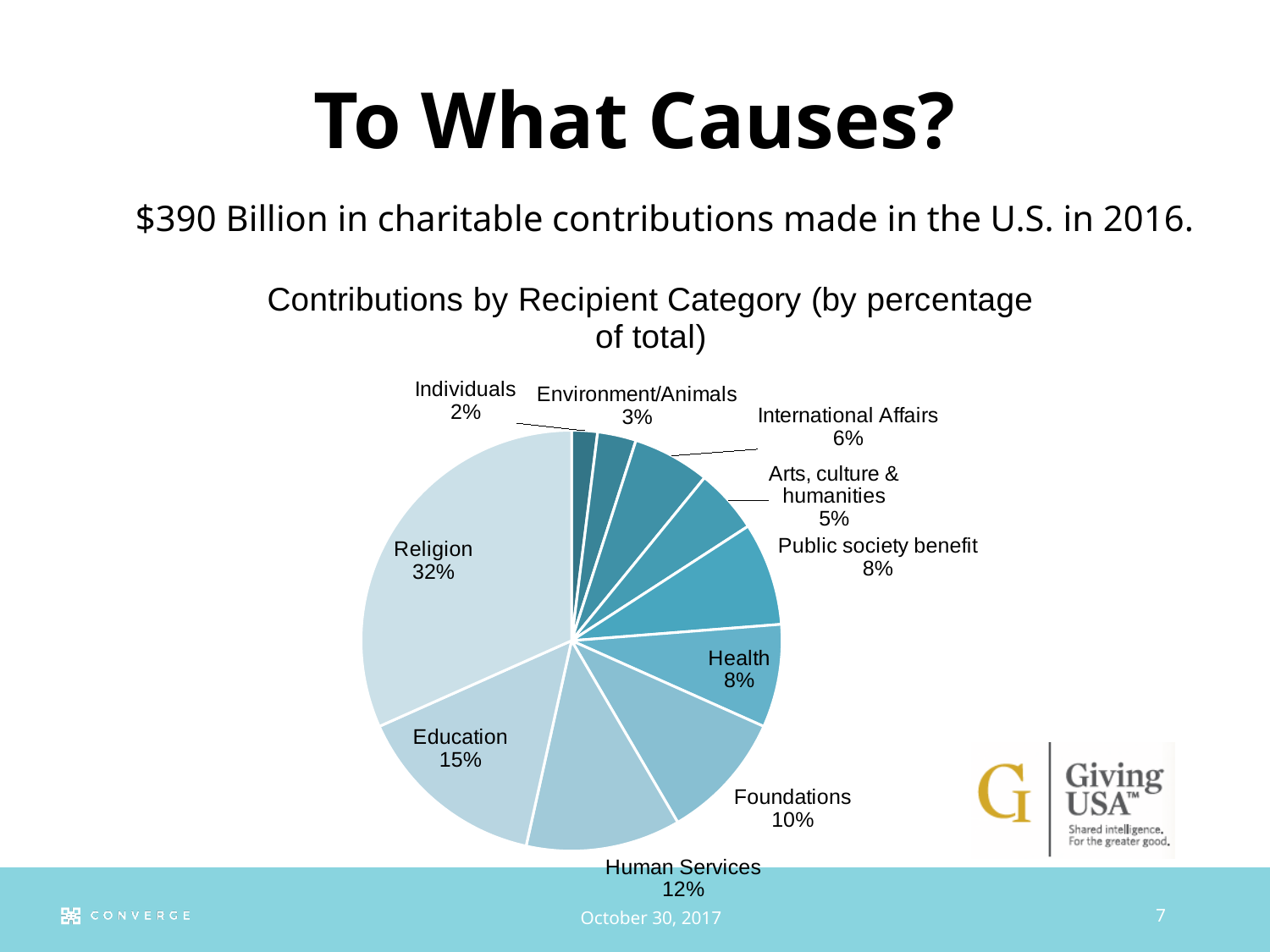
What is the combined share of Health and Public society benefit? 16% What kind of chart is shown on the slide? pie chart What is the difference in percentage points between Religion and Education? 17 Which received a larger share of contributions, International Affairs or Environment/Animals? International Affairs What percentage of contributions went to Foundations? 10% What percentage of contributions went to Arts, culture & humanities? 5% Which recipient category received the smallest share of contributions? Individuals What is the title of the chart? Contributions by Recipient Category (by percentage of total) How many recipient categories are shown in the pie chart? 10 What percentage of contributions went to Religion? 32% Which recipient category received the largest share of contributions? Religion What percentage of contributions went to Human Services? 12%